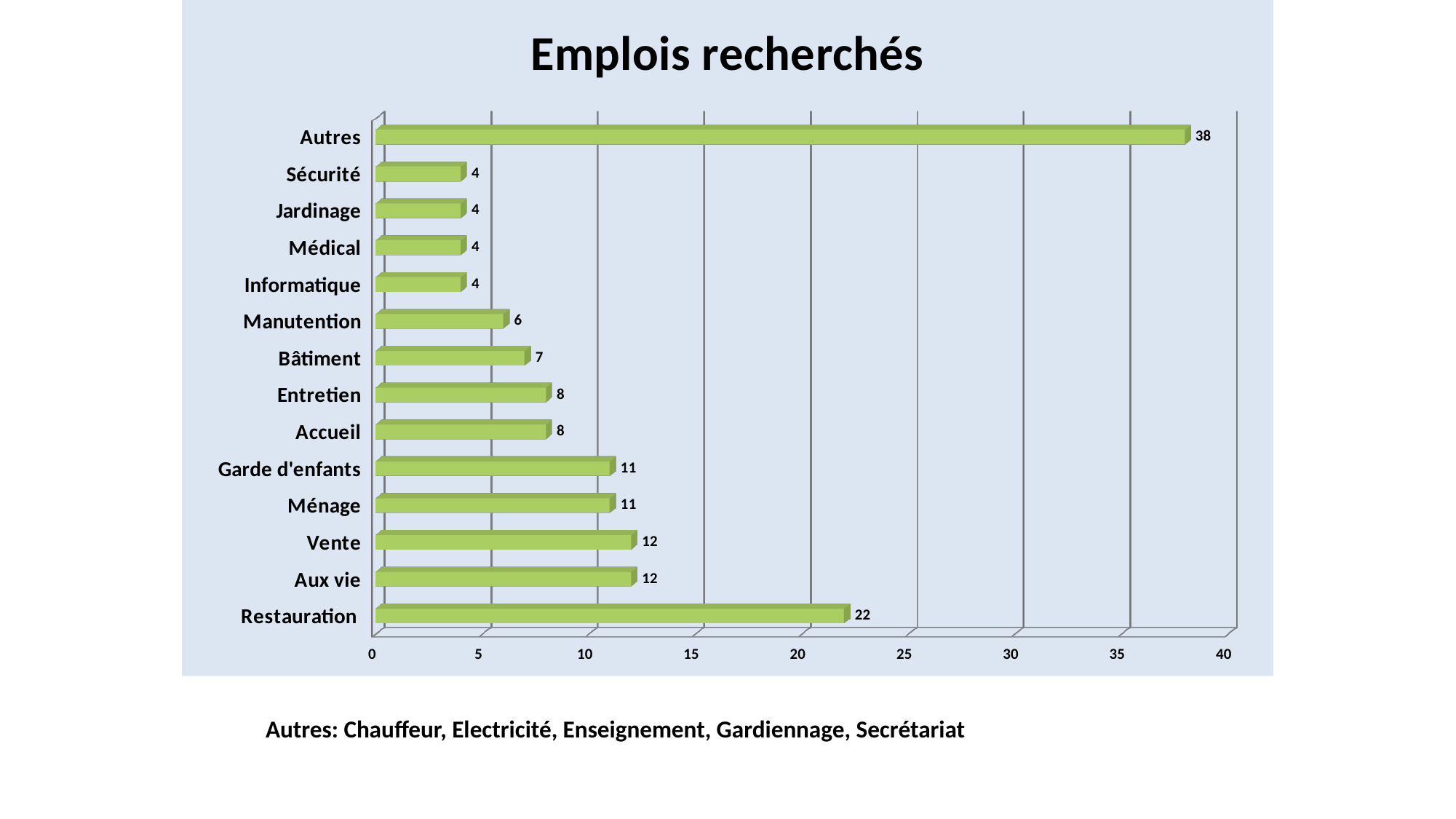
How many categories are shown in the chart? 14 What is the value for Aux vie? 12 What kind of chart is shown on the slide? Bar chart What is the value for Manutention? 6 Which category has the highest value? Autres What is the value for Restauration? 22 What is the value for Garde d'enfants? 11 Is the value for Restauration greater or less than 20? greater What is the difference between the values for Autres and Restauration? 16 What is the title of the chart? Emplois recherchés Which is larger, the value for Entretien or the value for Manutention? Entretien What is the difference between the values for Vente and Bâtiment? 5